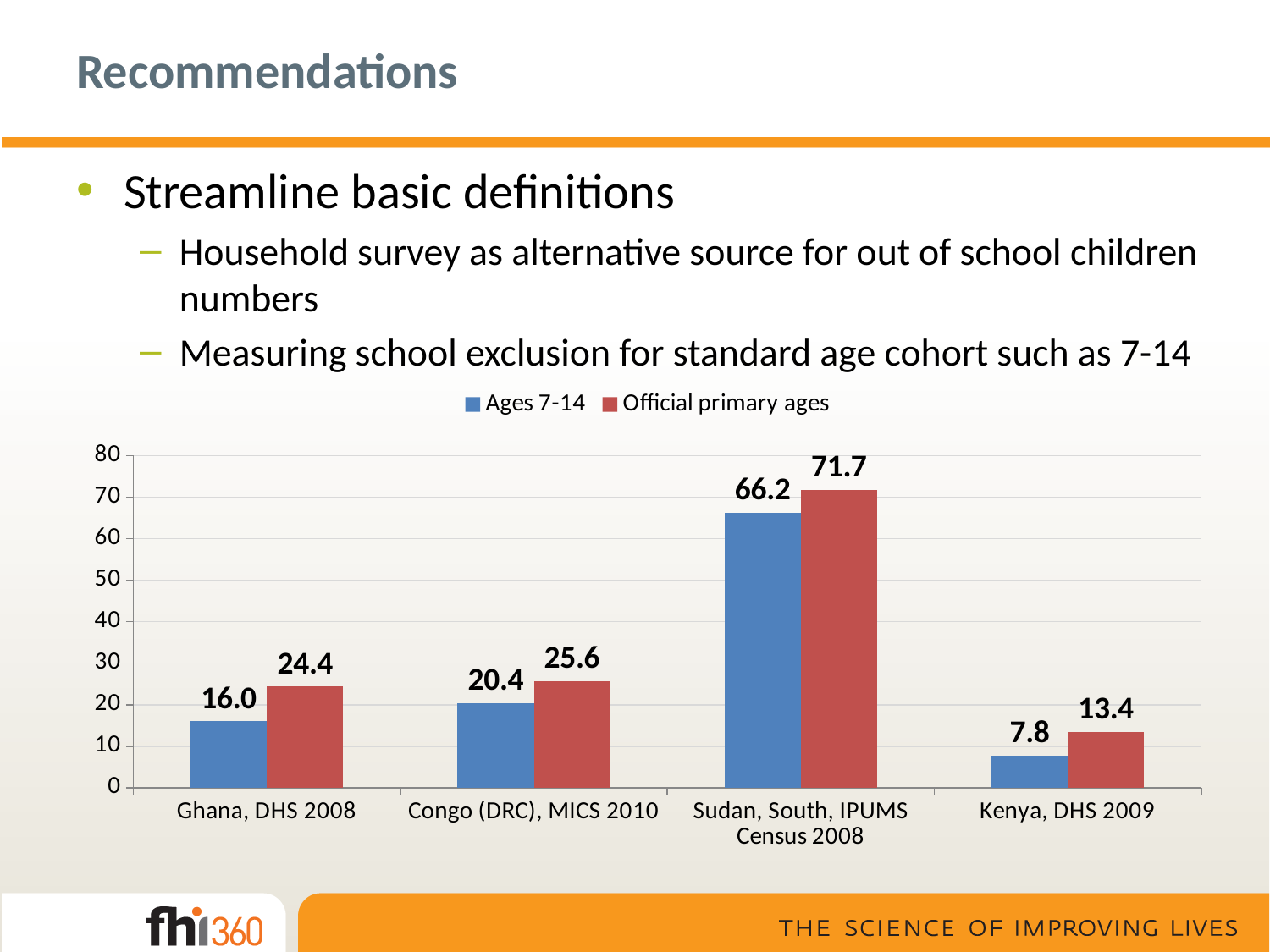
Which category has the lowest value for Official primary ages? Kenya, DHS 2009 What is the value for Ages 7-14 in Ghana, DHS 2008? 16.0 Which category has the highest value for Ages 7-14? Sudan, South, IPUMS Census 2008 Which is larger for Kenya, DHS 2009: the Ages 7-14 value or the Official primary ages value? Official primary ages What is the difference between the Official primary ages value and the Ages 7-14 value for Ghana, DHS 2008? 8.4 What is the value for Official primary ages in Kenya, DHS 2009? 13.4 How many series does the legend list? 2 What is the value for Official primary ages in Sudan, South, IPUMS Census 2008? 71.7 What is the difference between the Official primary ages value and the Ages 7-14 value for Congo (DRC), MICS 2010? 5.2 Is the Ages 7-14 value for Sudan, South, IPUMS Census 2008 greater or less than 60? greater How many categories are shown on the x axis? 4 What kind of chart is shown on the slide? Bar chart